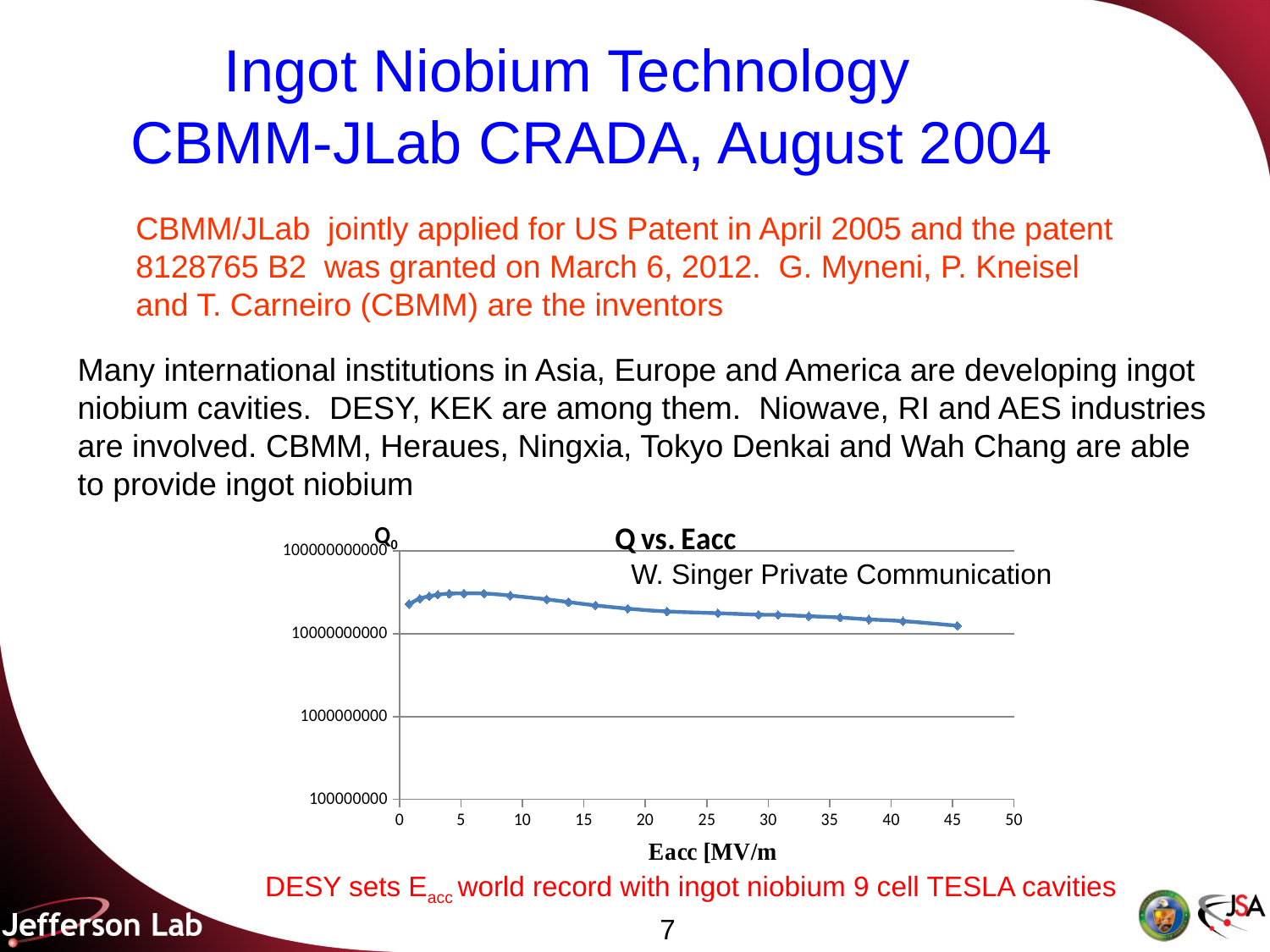
Which has the higher Q value: the point at Eacc of about 5 MV/m or the point at Eacc of about 40 MV/m? the point at about 5 MV/m Do the plotted Q values rise or fall as Eacc increases from 10 to 45 MV/m? fall Is the Q value at Eacc of about 30 MV/m greater or less than 1000000000? greater Is the Q value at Eacc of about 5 MV/m greater or less than 10000000000? greater What is the label of the x axis of the chart? Eacc [MV/m What is the title of the chart? Q vs. Eacc What kind of chart is shown on the slide? line chart What is the highest value shown on the x axis of the chart? 50 Is the Q value at Eacc of about 5 MV/m greater or less than 100000000000? less